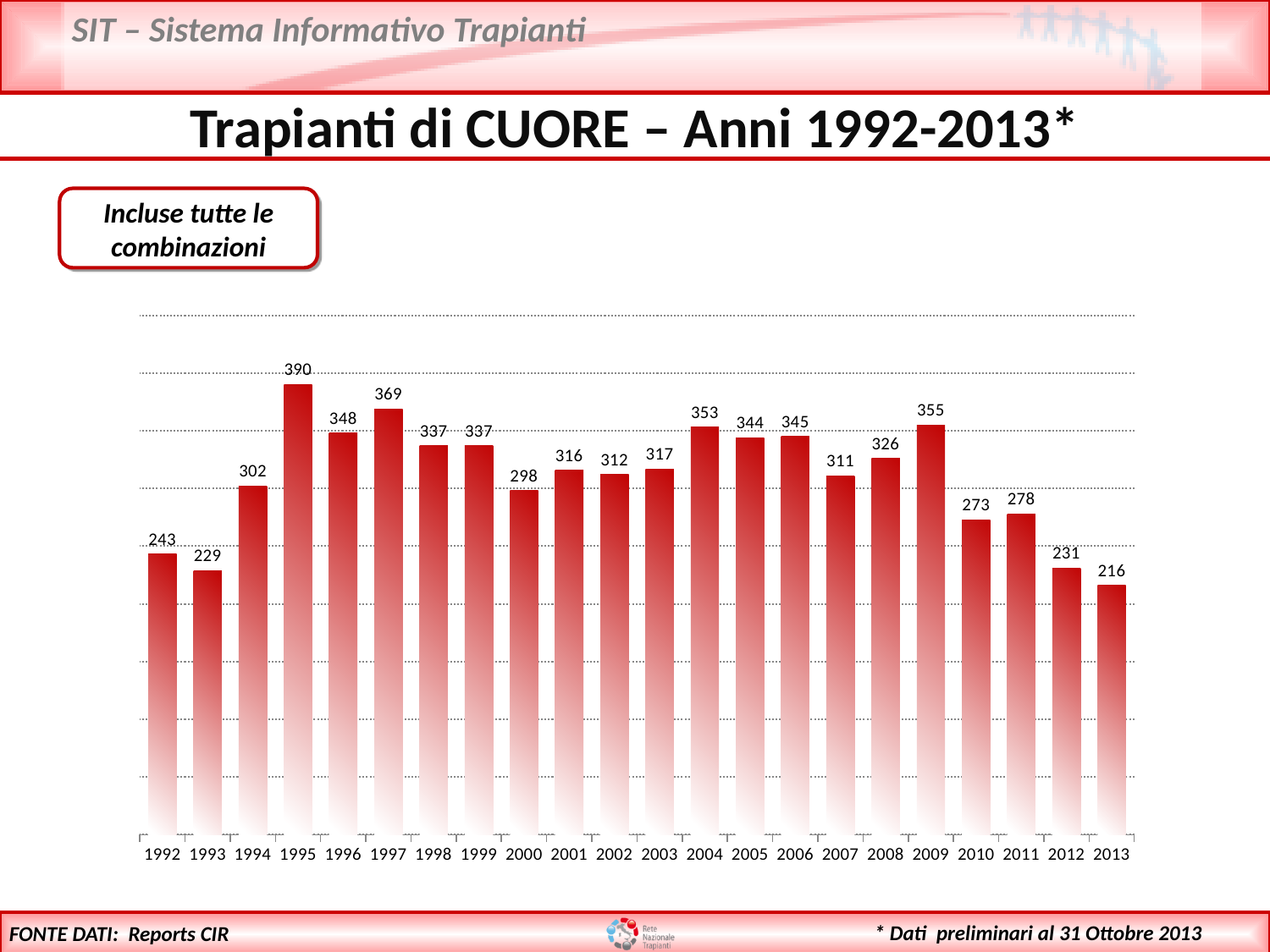
What is the value for 2004? 353 Which year has the highest value? 1995 What is the value for 1995? 390 What is the difference between the values for 2009 and 2010? 82 What is the difference between the values for 1995 and 2013? 174 Which is larger, the value for 1997 or the value for 2009? 1997 What is the title of the chart? Trapianti di CUORE – Anni 1992-2013* Do the values rise or fall from 2009 to 2013? fall Which year has the lowest value? 2013 What kind of chart is this? bar chart What is the value for 2013? 216 How many years are shown on the x axis? 22